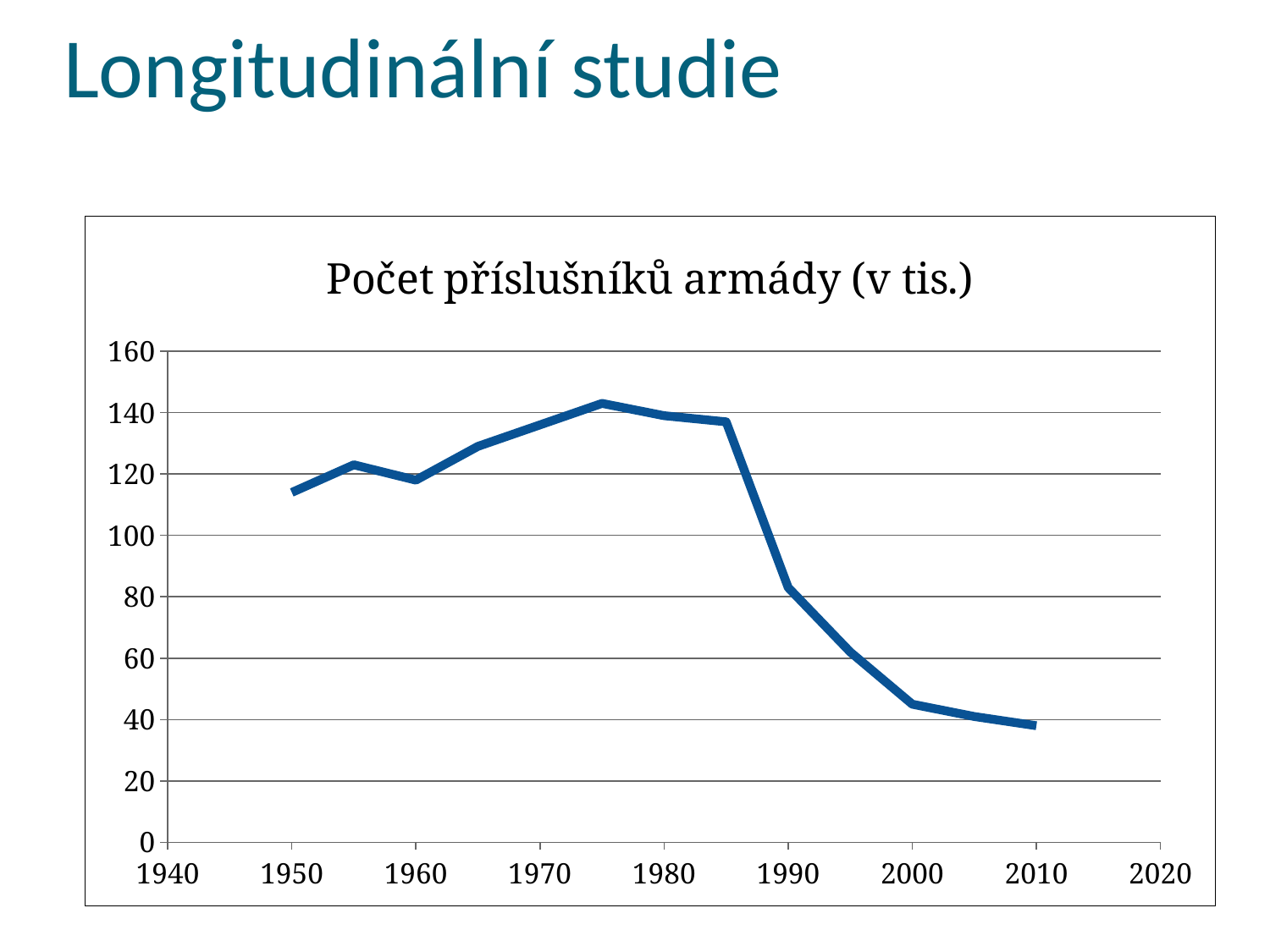
Is the value for 1990 greater or less than 100? less What kind of chart is shown on the slide? line chart Is the value for 1975 greater or less than 120? greater Is the value for 2000 greater or less than 60? less In which year does the line reach its highest value? 1975 Which year has the larger value, 1975 or 2000? 1975 In which year does the line reach its lowest value? 2010 Do the values rise or fall between 1985 and 2010? fall What is the title of the chart? Počet příslušníků armády (v tis.)